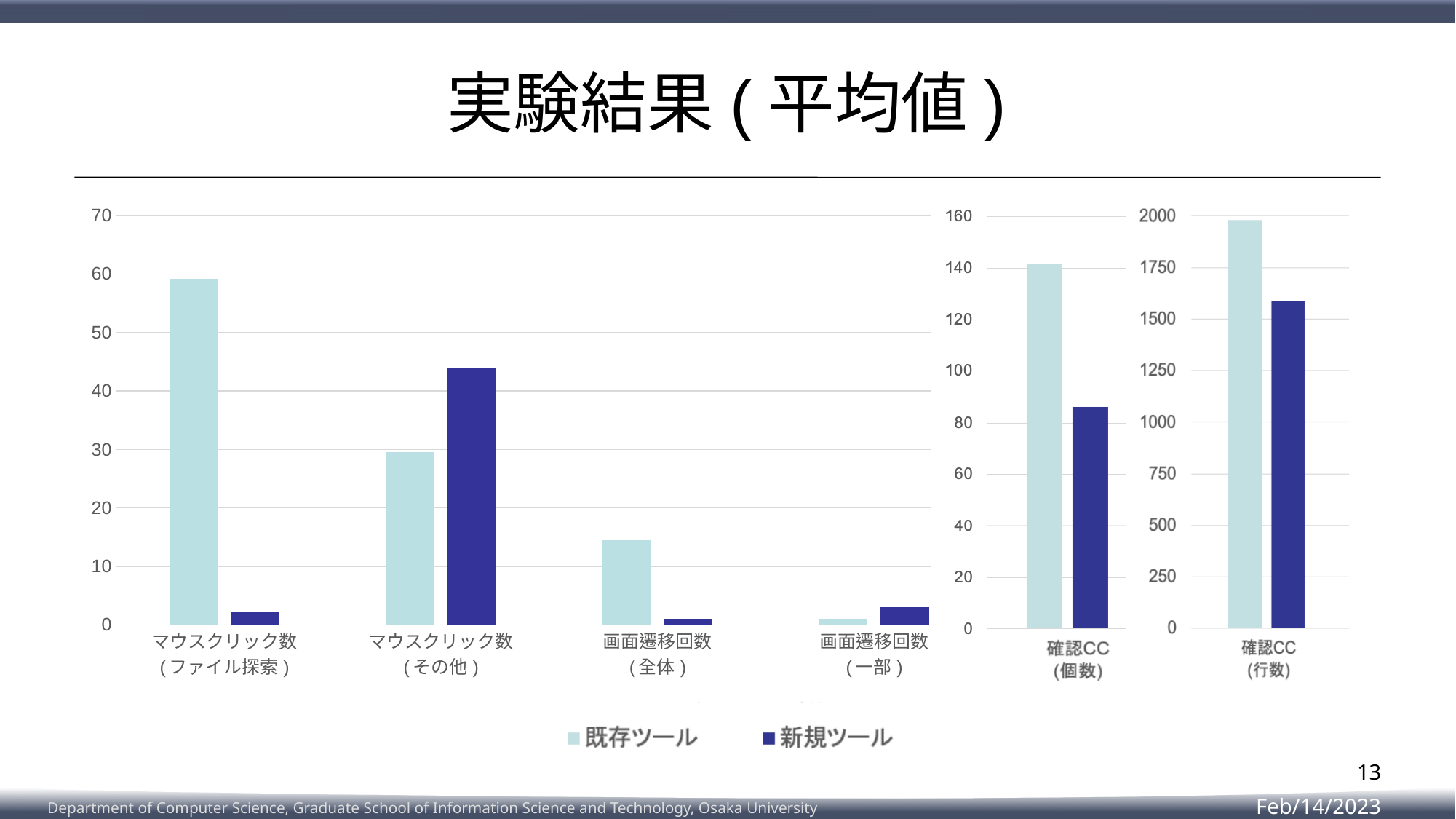
In the left chart, is the 既存ツール value for 画面遷移回数（全体） greater or less than 10? greater In the 確認CC（行数） chart, is the 新規ツール value greater or less than 1750? less In the 確認CC（個数） chart, is the 既存ツール value greater or less than 120? greater Which series is shown in dark blue in the legend? 新規ツール In the left chart, for 画面遷移回数（一部）, which series has the larger value, 既存ツール or 新規ツール? 新規ツール How many series does the legend list? 2 In the left chart, which category has the highest value for 新規ツール? マウスクリック数（その他） In the left chart, which category has the highest value for 既存ツール? マウスクリック数（ファイル探索） How many categories does the left chart show on its x axis? 4 What kind of chart is the left chart with the four categories? bar chart